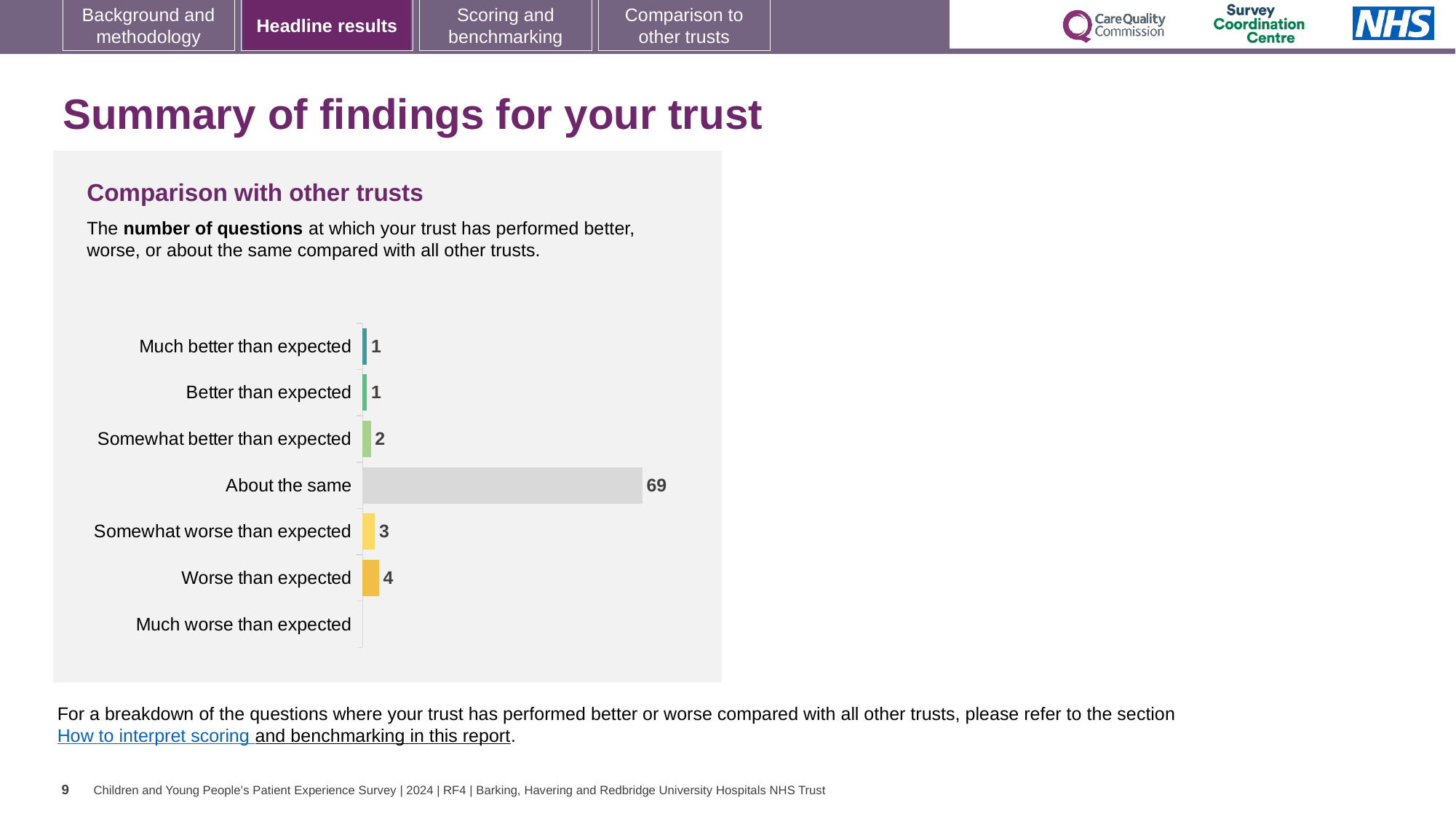
What kind of chart is shown on the slide? bar chart Which category has the highest value? About the same What is the title of the chart? Comparison with other trusts How many categories are shown on the chart? 7 What is the value for 'Much better than expected'? 1 What is the difference between 'About the same' and 'Worse than expected'? 65 How many questions were rated 'About the same'? 69 What is the value for 'Somewhat worse than expected'? 3 What is the value for 'Worse than expected'? 4 Which is larger, 'Worse than expected' or 'Somewhat worse than expected'? Worse than expected What is the total number of questions rated better than expected (much better, better, and somewhat better combined)? 4 What is the value for 'Somewhat better than expected'? 2